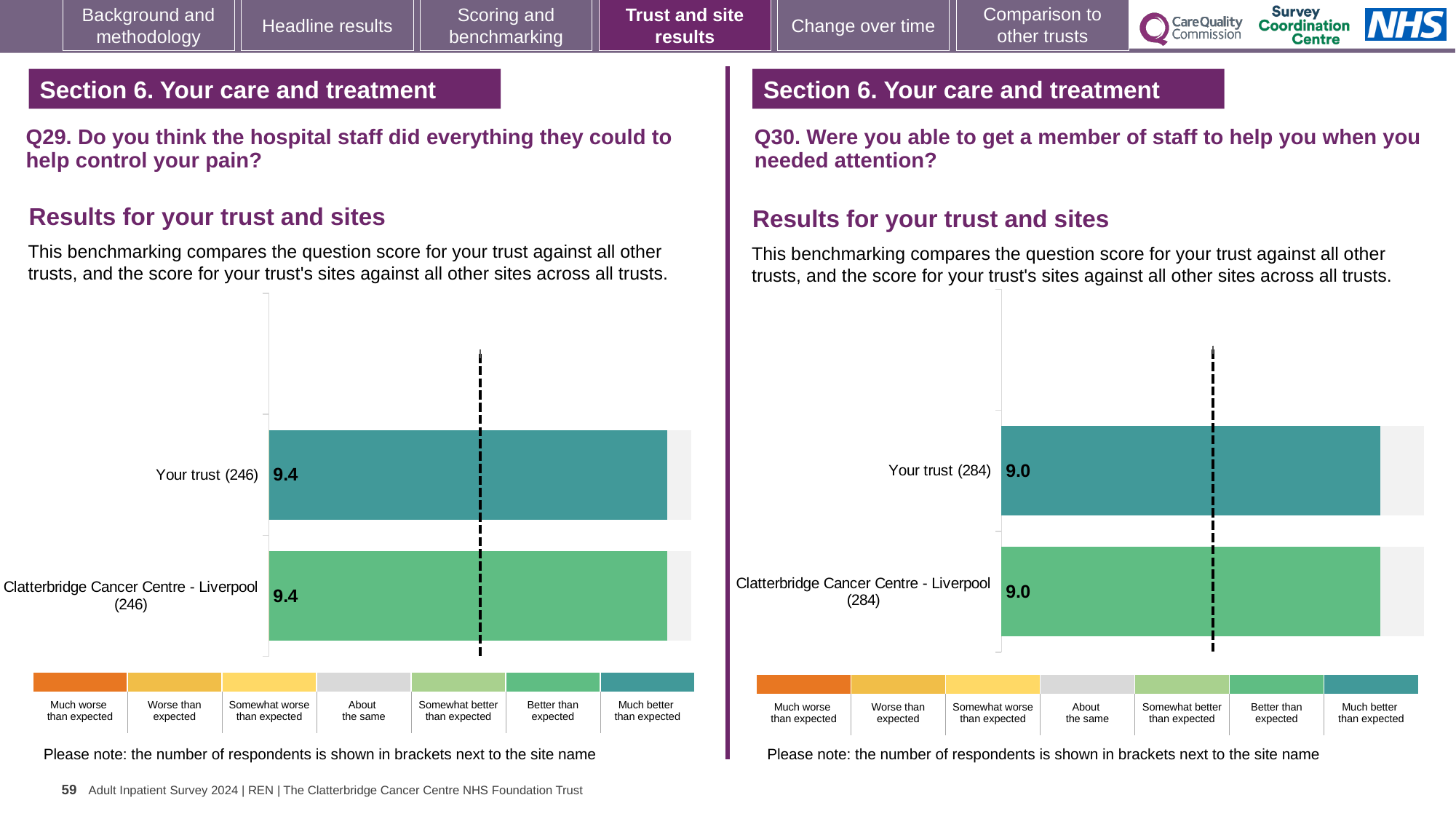
In the Q30 chart on the right, what is the score for Your trust (284)? 9.0 In the Q29 chart on the left, how many respondents are shown in brackets for Your trust? 246 How many bars are plotted in the Q29 chart on the left? 2 What kind of chart is used in the Q30 chart on the right? Bar chart In the Q29 chart on the left, what is the score for Your trust (246)? 9.4 In the Q29 chart on the left, what is the score for Clatterbridge Cancer Centre - Liverpool (246)? 9.4 In the Q30 chart on the right, which benchmark category does the colour of the Your trust bar correspond to in the key below the chart? Much better than expected Is the score for Your trust higher in the Q29 chart on the left or in the Q30 chart on the right? Q29 chart on the left In the Q30 chart on the right, what is the difference between the score for Your trust and the score for Clatterbridge Cancer Centre - Liverpool? 0.0 How many bars are plotted in the Q30 chart on the right? 2 In the Q30 chart on the right, what is the score for Clatterbridge Cancer Centre - Liverpool (284)? 9.0 In the Q29 chart on the left, what is the difference between the score for Your trust and the score for Clatterbridge Cancer Centre - Liverpool? 0.0